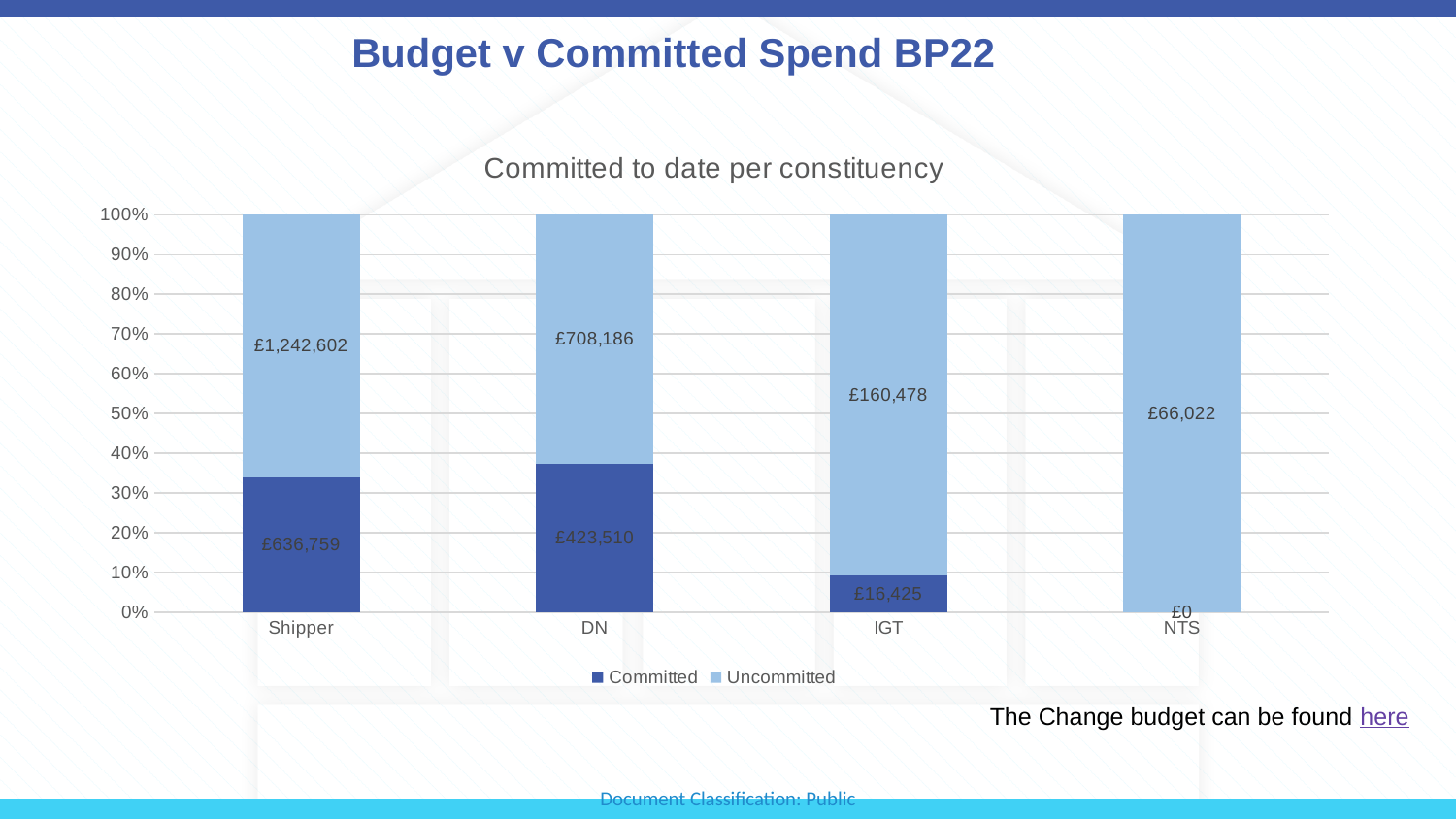
What is the Uncommitted value for DN? £708,186 Which constituency has the highest Uncommitted value? Shipper What is the difference between the Uncommitted values for Shipper and DN? £534,416 What is the total of the Committed and Uncommitted values for IGT? £176,903 What is the Committed value for IGT? £16,425 What is the Committed value for Shipper? £636,759 What is the Uncommitted value for NTS? £66,022 How many constituencies are shown on the x axis? 4 How many series does the legend list? 2 Which constituency has the lowest Committed value? NTS Which is larger, the Committed value for DN or the Committed value for IGT? DN Is the Committed share of the Shipper bar greater or less than 30%? greater